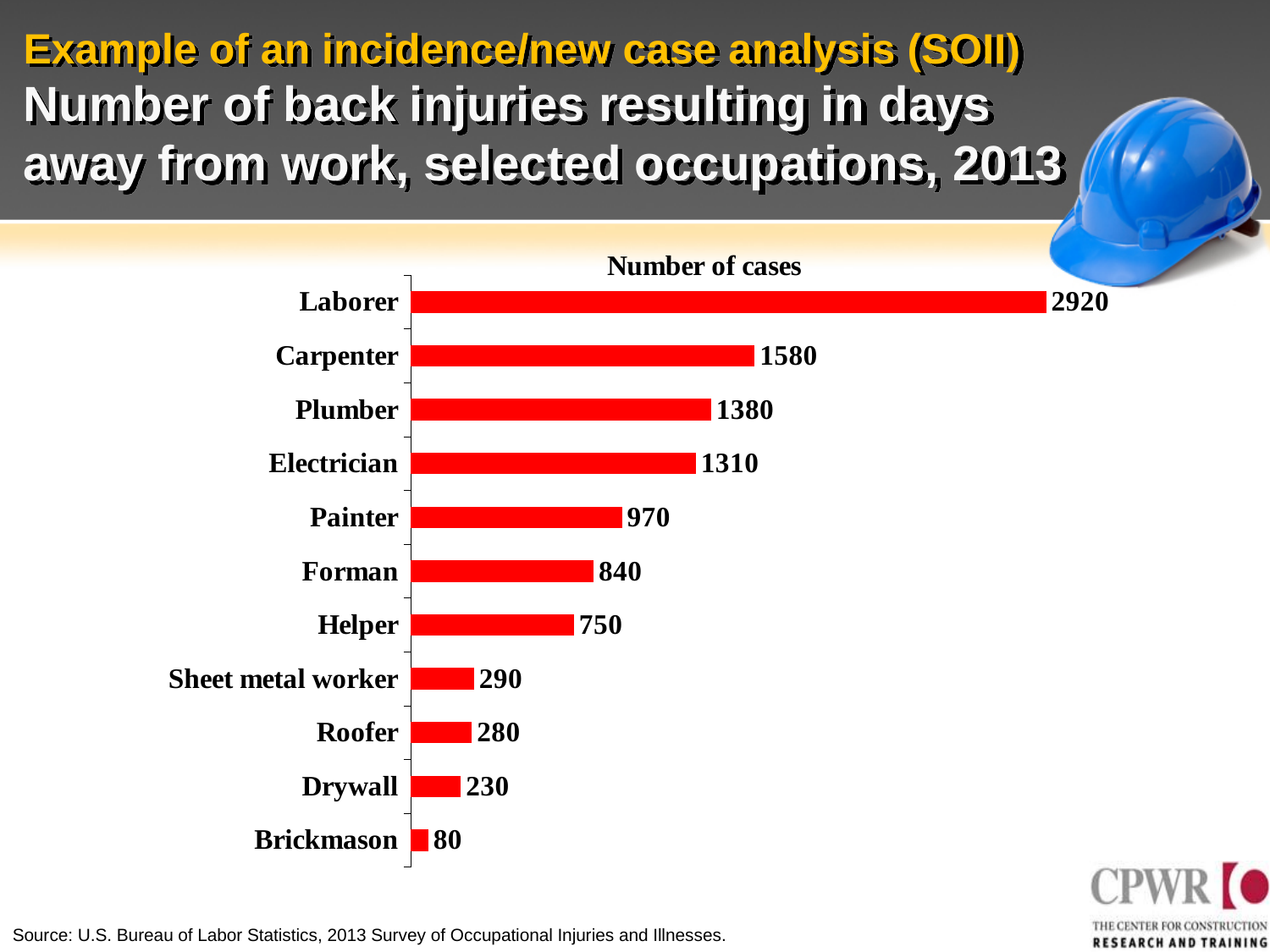
Which occupation has the lowest number of cases? Brickmason Which has more cases, Helper or Drywall? Helper What is the number of cases for Sheet metal worker? 290 How many occupations are shown in the chart? 11 Which occupation has the highest number of cases? Laborer What is the title shown above the chart's bars? Number of cases Which has more cases, Plumber or Electrician? Plumber What is the difference in number of cases between Laborer and Carpenter? 1340 What type of chart is used on this slide? Bar chart What is the number of cases for Electrician? 1310 What is the difference in number of cases between Painter and Forman? 130 How many back injury cases resulting in days away from work are shown for Laborer? 2920